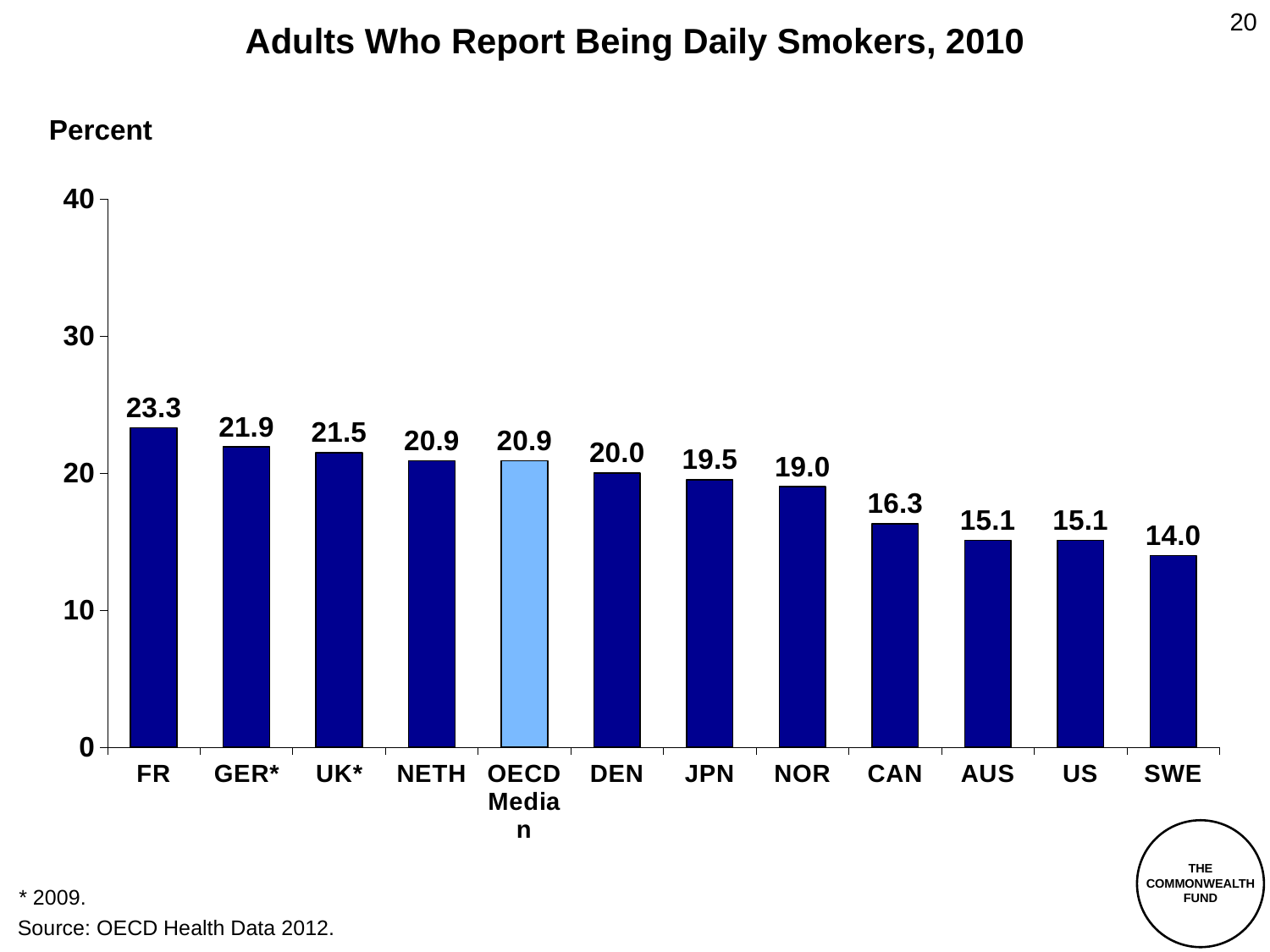
What kind of chart is this? bar chart What is the value for FR? 23.3 What is the title of the chart? Adults Who Report Being Daily Smokers, 2010 Which category has the highest value? FR What is the value for the OECD Median? 20.9 How many categories are shown on the x axis? 12 What is the difference between the values for GER* and US? 6.8 What is the value for CAN? 16.3 What is the difference between the values for FR and SWE? 9.3 Which is larger, the value for DEN or the value for NOR? DEN Which category has the lowest value? SWE Is the value for JPN greater or less than 20? less